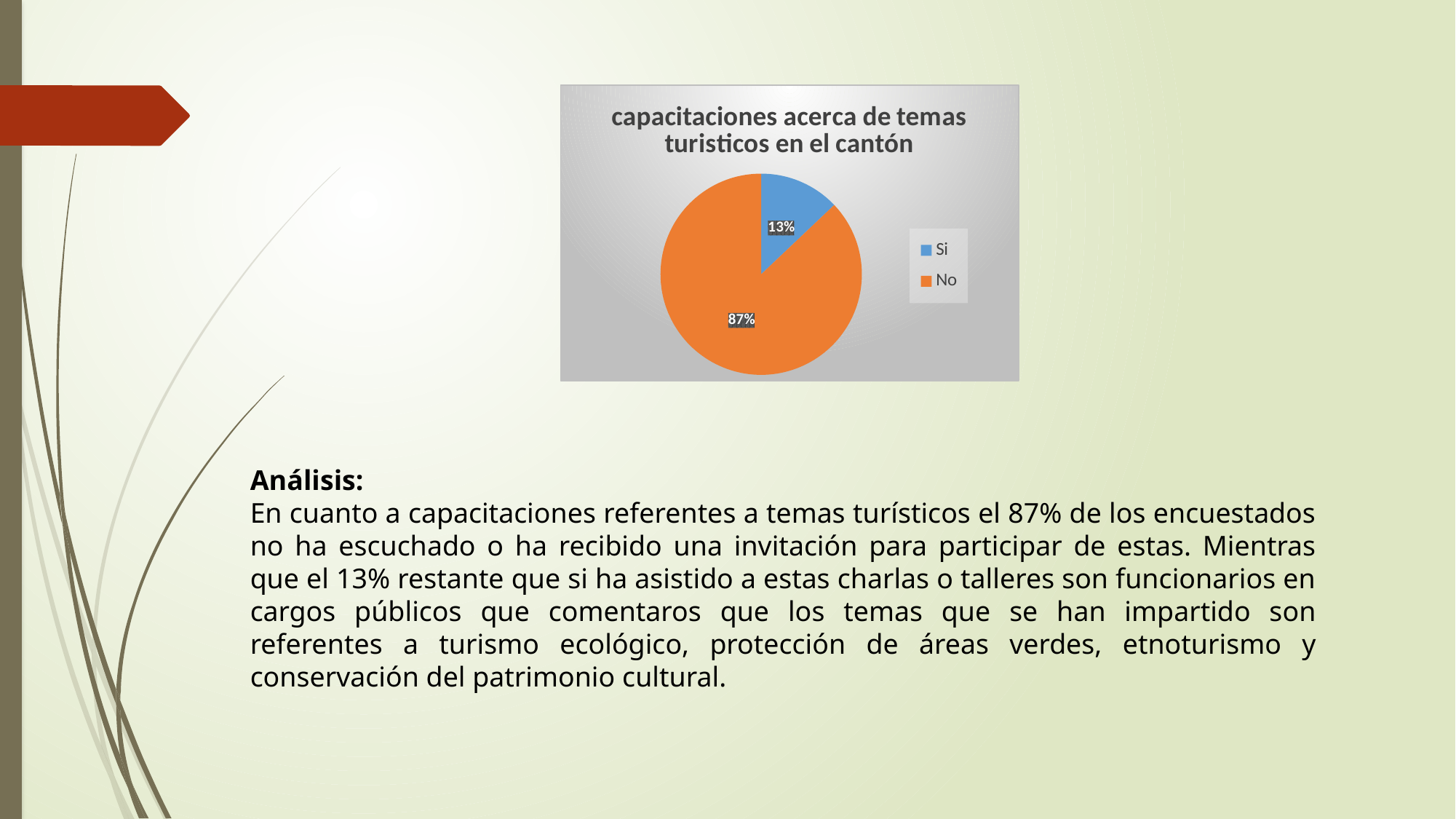
Which is larger, the "Si" slice or the "No" slice? No What percentage of the pie does the "Si" slice represent? 13% What is the total of the two slice percentages shown on the pie? 100% What is the difference in percentage points between the "No" slice and the "Si" slice? 74 What is the title of the chart? capacitaciones acerca de temas turisticos en el cantón What kind of chart is shown on the slide? pie chart How many entries does the legend list? 2 Which category has the smallest share of the pie? Si What colour is the "No" slice of the pie? orange How many categories does the pie chart show? 2 What percentage of the pie does the "No" slice represent? 87% Which category has the largest share of the pie? No